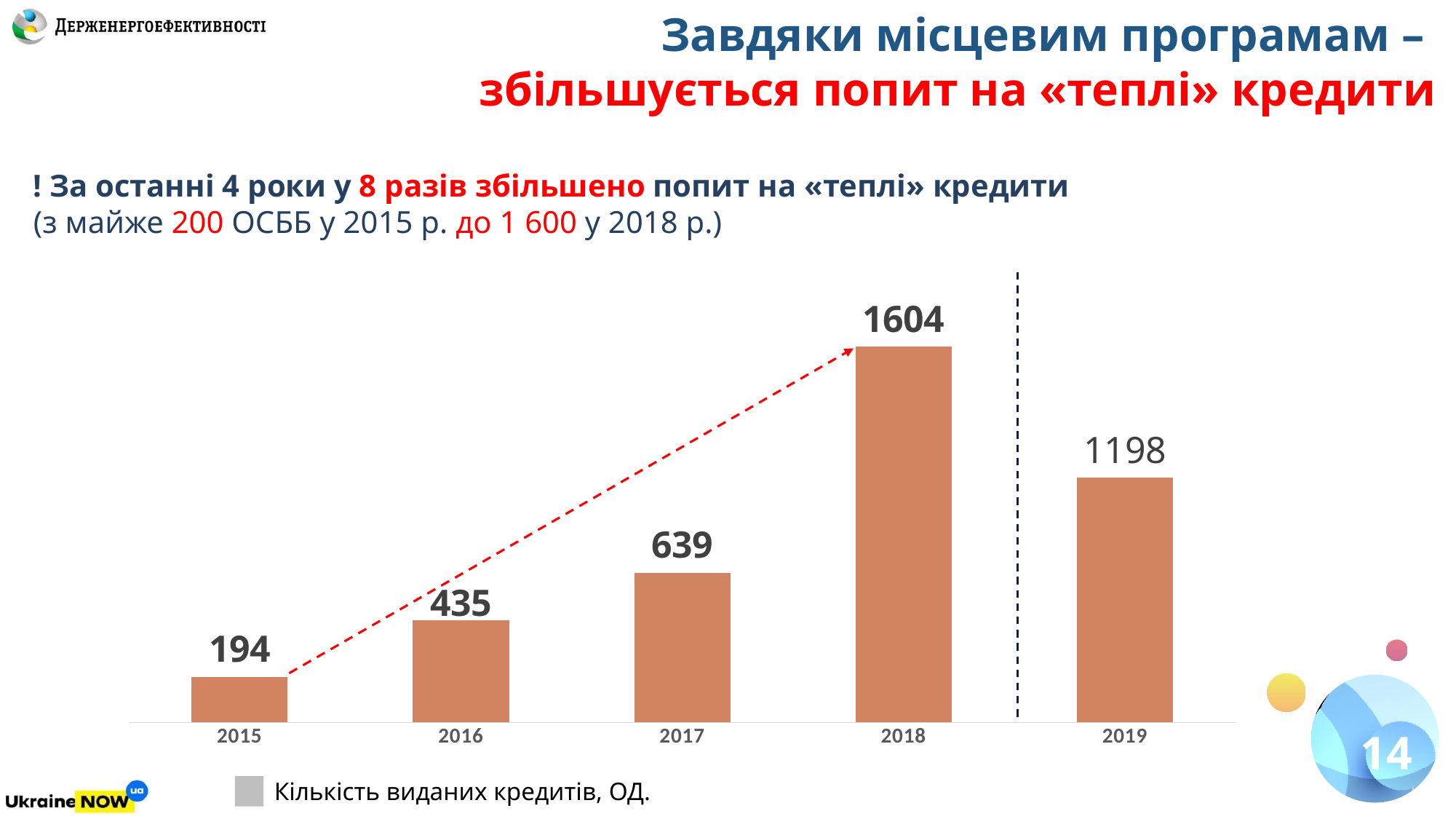
Which is larger, the value for 2018 or the value for 2019? 2018 Which year has the highest value? 2018 What is the value for 2015? 194 How many series does the legend list? 1 What is the value for 2017? 639 What is the difference between the values for 2018 and 2017? 965 What kind of chart is shown? bar chart What is the value for 2019? 1198 What is the difference between the values for 2016 and 2015? 241 Which year has the lowest value? 2015 Do the values rise or fall from 2015 to 2018? rise How many years are shown on the x axis? 5